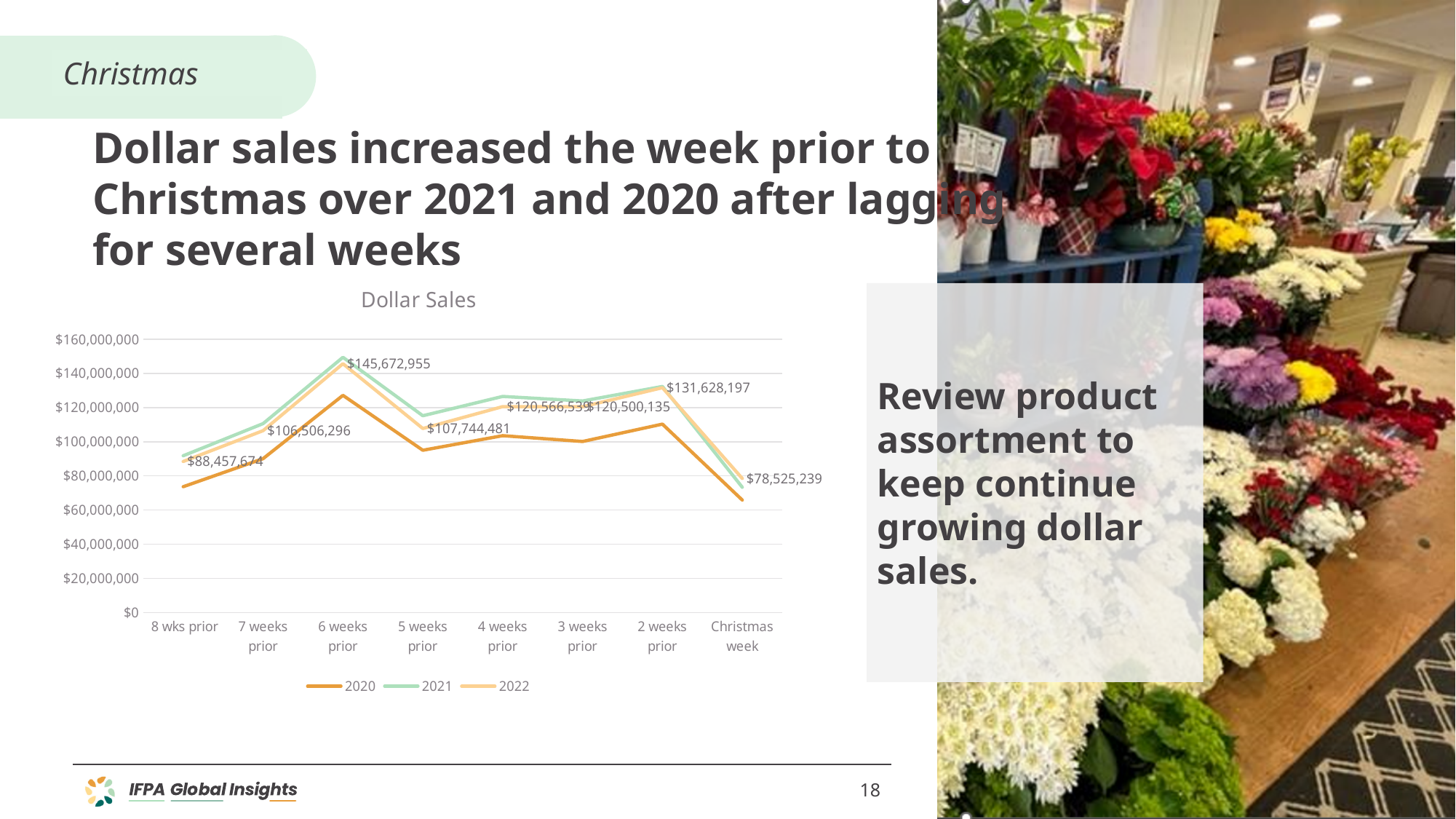
What is the 2022 dollar sales value for 6 weeks prior? $145,672,955 What is the title of the chart? Dollar Sales For 2022, which is larger: the value for 8 wks prior or the value for 2 weeks prior? 2 weeks prior How many time periods are shown along the x axis of the Dollar Sales chart? 8 Is the 2020 value for 6 weeks prior greater or less than $140,000,000? less What kind of chart is shown on the slide? line chart How many series does the legend of the Dollar Sales chart list? 3 In which period does the 2022 series reach its highest value? 6 weeks prior In which period does the 2022 series have its lowest value? Christmas week What is the difference between the 2022 values for 2 weeks prior and Christmas week? $53,102,958 What is the 2022 dollar sales value for Christmas week? $78,525,239 What is the 2022 dollar sales value for 2 weeks prior? $131,628,197